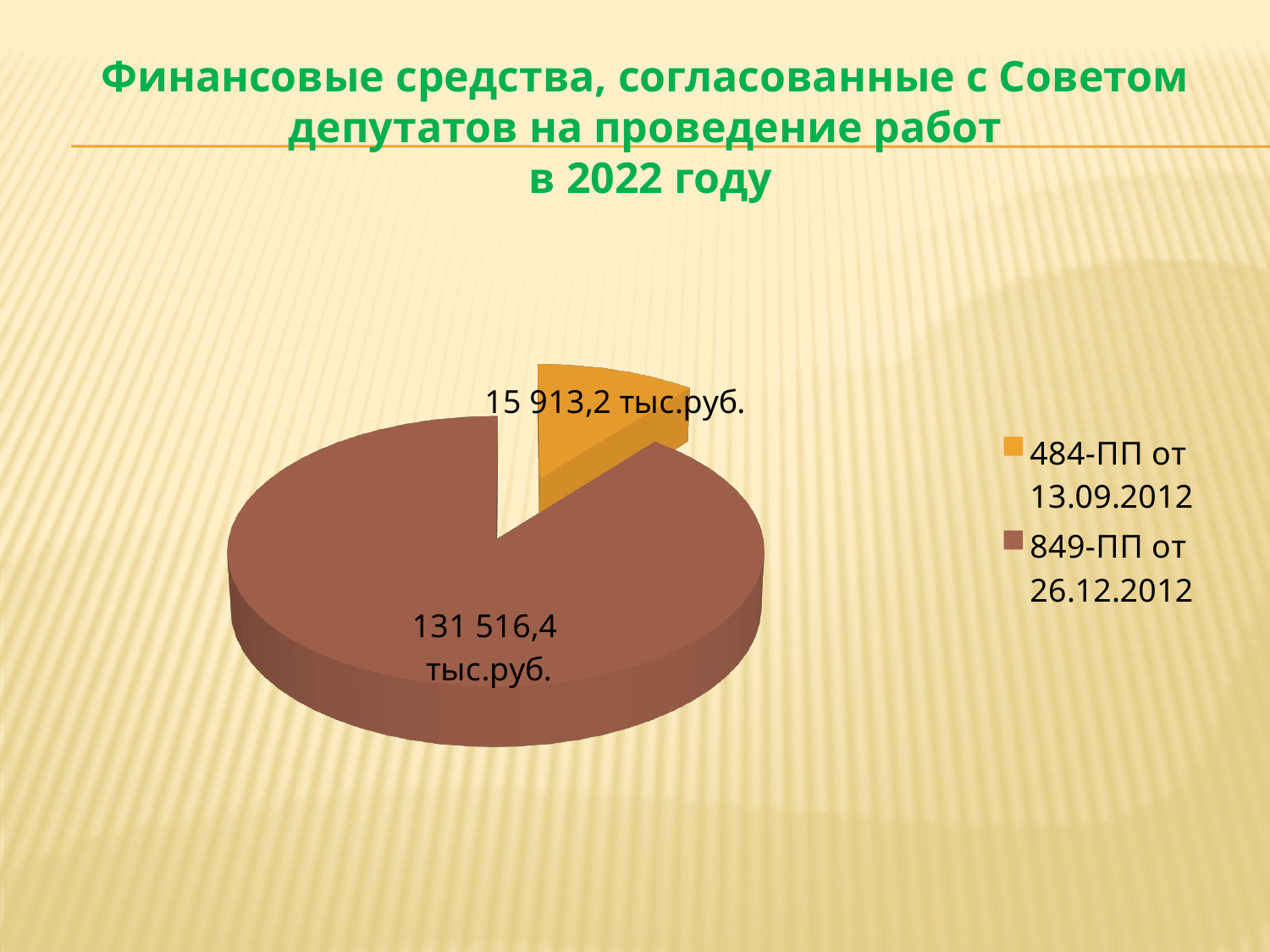
What is the value for 484-ПП от 13.09.2012? 15 913,2 тыс.руб. What is the difference between the value for 849-ПП от 26.12.2012 and the value for 484-ПП от 13.09.2012? 115 603,2 тыс.руб. What colour is the slice for 484-ПП от 13.09.2012? orange What is the total of the two values shown in the pie chart? 147 429,6 тыс.руб. How many entries does the legend list? 2 Which category has the largest slice of the pie? 849-ПП от 26.12.2012 What type of chart is shown on the slide? pie chart Which is larger: the value for 484-ПП от 13.09.2012 or the value for 849-ПП от 26.12.2012? 849-ПП от 26.12.2012 Which category has the smallest slice of the pie? 484-ПП от 13.09.2012 What year is named in the chart's title? 2022 How many slices does the pie chart have? 2 What is the value for 849-ПП от 26.12.2012? 131 516,4 тыс.руб.